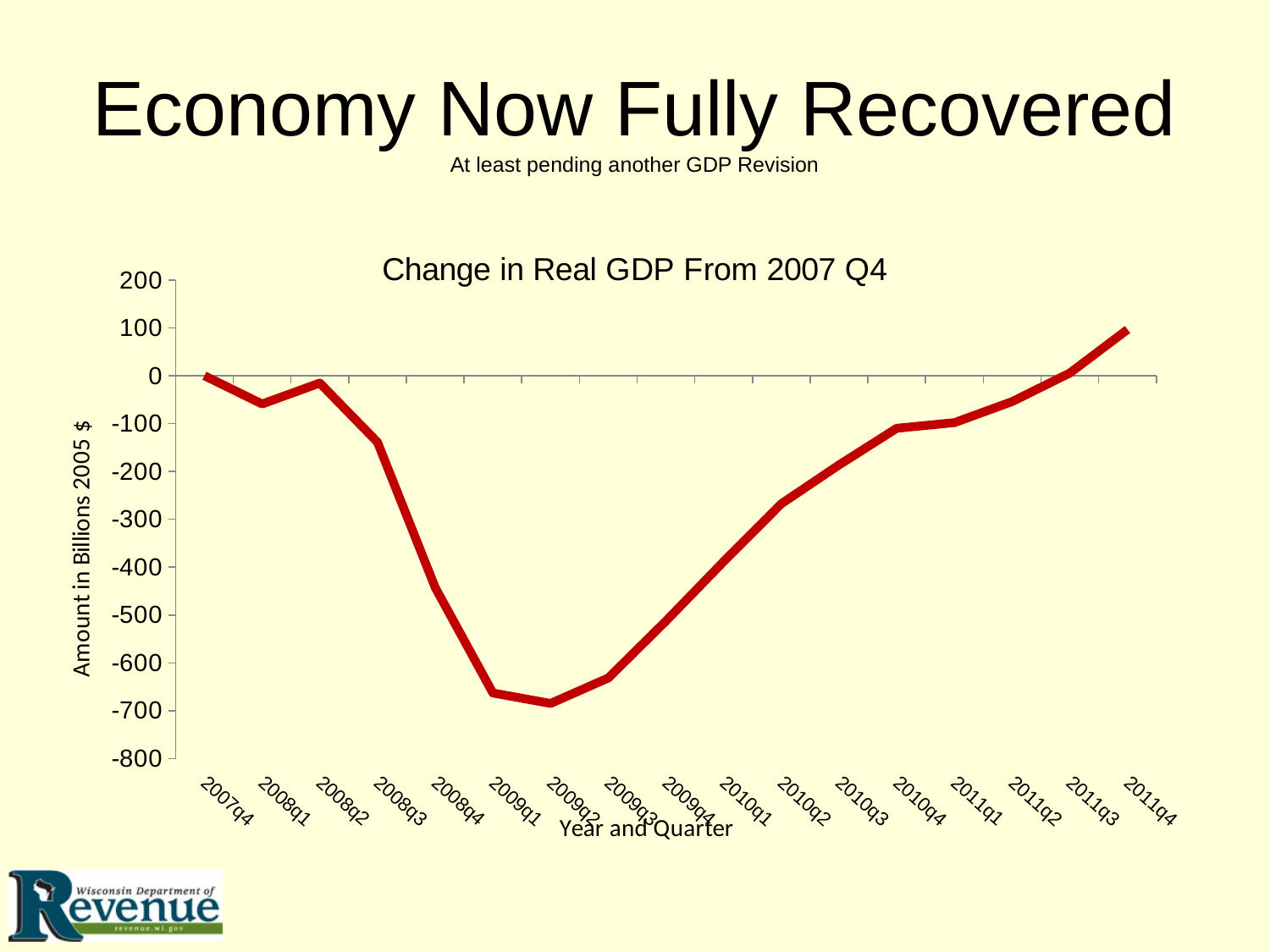
Which is larger, the value for 2008q4 or the value for 2010q2? 2010q2 Do the values rise or fall from 2009q2 to 2011q4? rise Is the value for 2011q4 greater or less than 0? greater What kind of chart is shown on the slide? line chart What is the label of the vertical axis? Amount in Billions 2005 $ What is the title of the chart? Change in Real GDP From 2007 Q4 Is the value for 2009q2 greater or less than -600? less Is the value for 2010q1 greater or less than -200? less How many quarters are plotted along the x axis? 17 Which quarter has the lowest value? 2009q2 What is the value for 2007q4? 0 Which quarter has the highest value? 2011q4